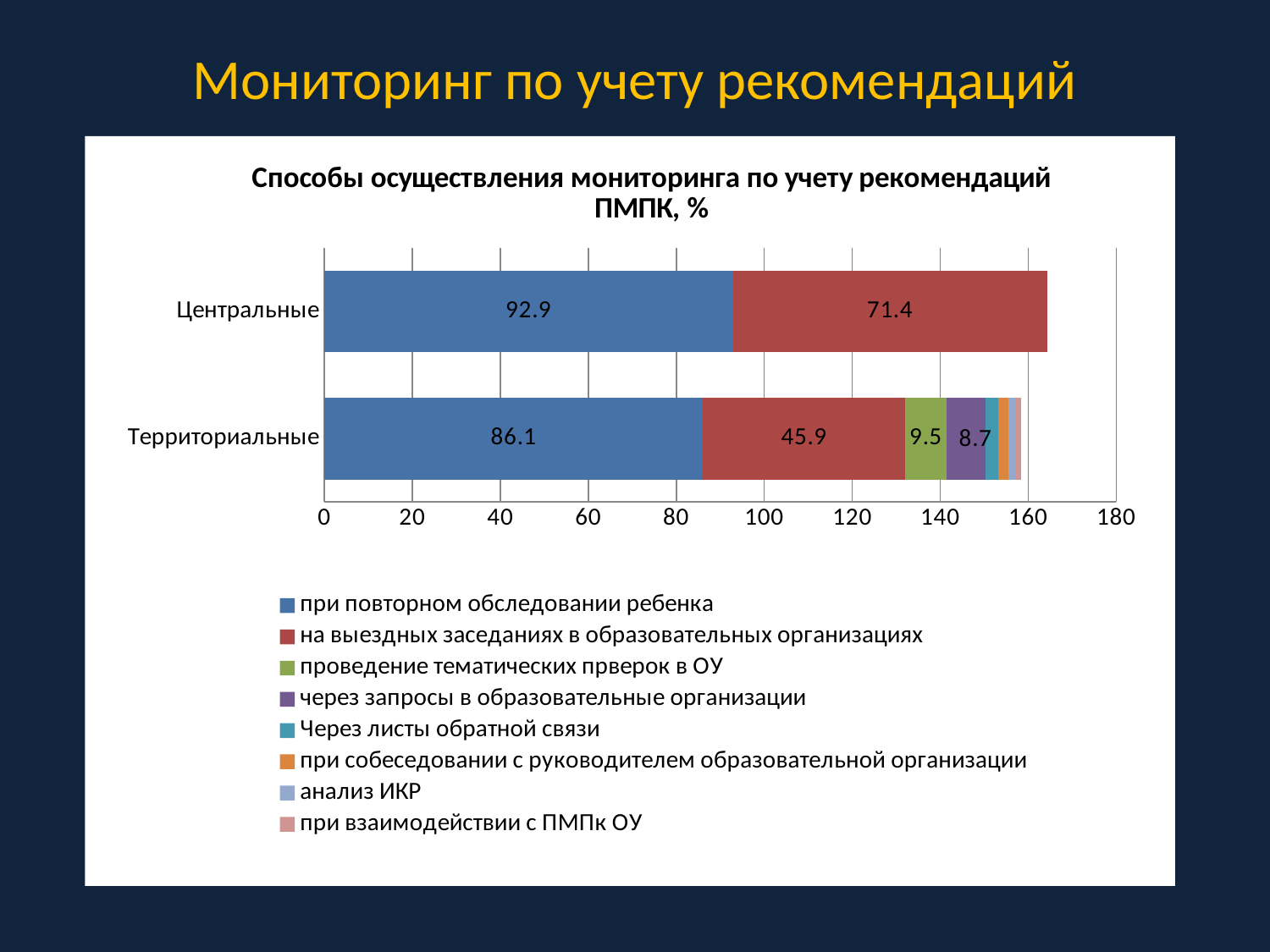
What is the value for Территориальные in the series 'на выездных заседаниях в образовательных организациях'? 45.9 How many categories are shown on the vertical axis? 2 What is the difference between Центральные and Территориальные in the series 'при повторном обследовании ребенка'? 6.8 What is the value for Центральные in the series 'при повторном обследовании ребенка'? 92.9 What is the value for Центральные in the series 'на выездных заседаниях в образовательных организациях'? 71.4 What is the value for Территориальные in the series 'через запросы в образовательные организации'? 8.7 How many series does the legend list? 8 What kind of chart is shown on the slide? Stacked bar chart Which category has the larger value in the series 'на выездных заседаниях в образовательных организациях', Центральные or Территориальные? Центральные What is the value for Территориальные in the series 'при повторном обследовании ребенка'? 86.1 What is the total of the stacked bar for Центральные? 164.3 What is the value for Территориальные in the series 'проведение тематических прверок в ОУ'? 9.5